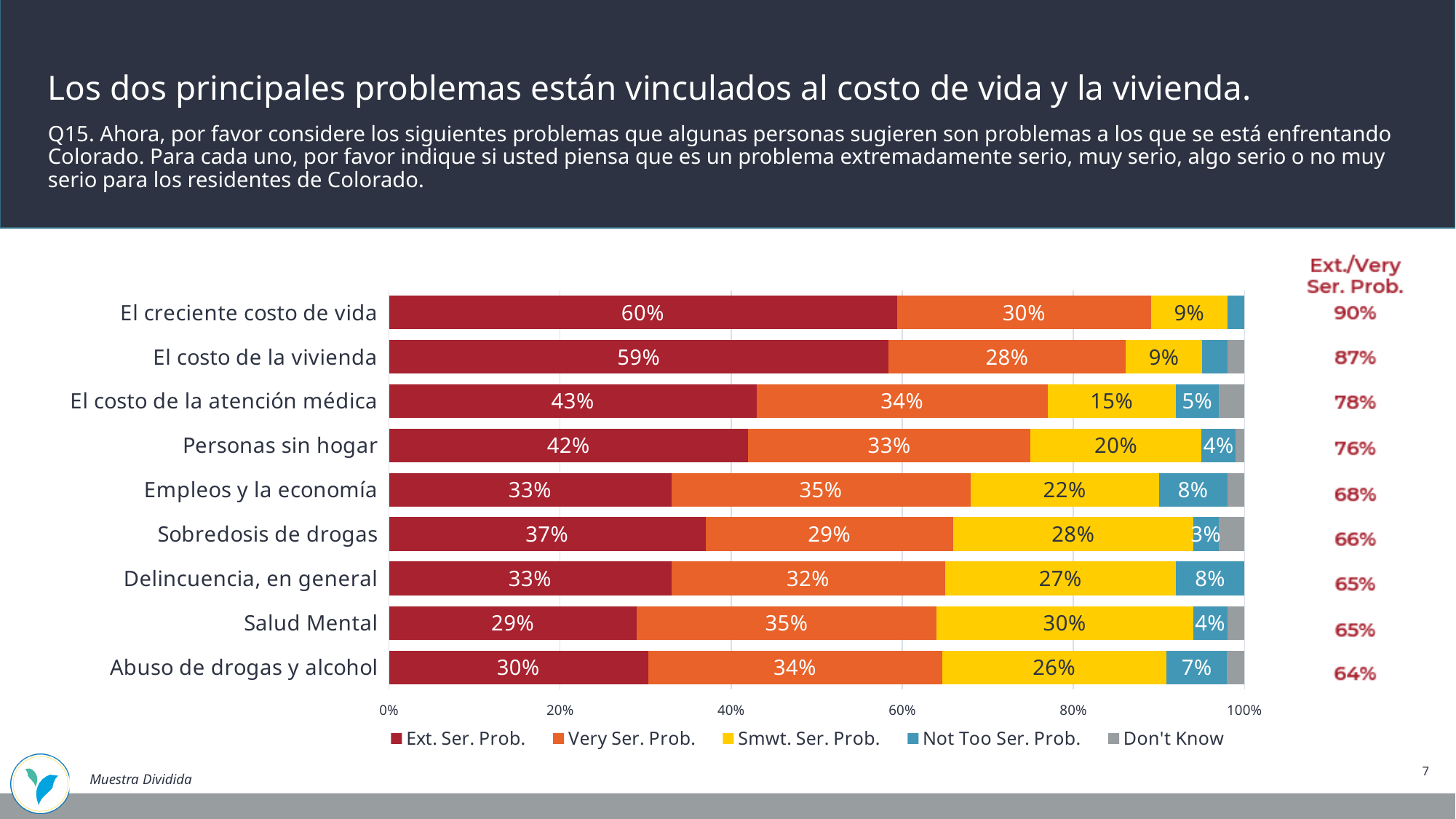
What kind of chart is shown on the slide? Stacked bar chart What is the difference between the 'Ext. Ser. Prob.' values for 'El creciente costo de vida' and 'Salud Mental'? 31 percentage points How many problem categories are shown in the chart? 9 What is the combined Ext./Very Ser. Prob. figure shown for 'El costo de la vivienda'? 87% What percentage of respondents rated 'El creciente costo de vida' as an extremely serious problem (Ext. Ser. Prob.)? 60% How many series does the legend list? 5 What is the 'Very Ser. Prob.' value for 'El costo de la atención médica'? 34% Which category has the highest 'Ext. Ser. Prob.' value? El creciente costo de vida Which has a larger 'Ext. Ser. Prob.' value: 'Sobredosis de drogas' or 'Delincuencia, en general'? Sobredosis de drogas Which category has the lowest 'Ext. Ser. Prob.' value? Salud Mental What is the 'Not Too Ser. Prob.' value for 'Empleos y la economía'? 8% What is the 'Smwt. Ser. Prob.' value for 'Personas sin hogar'? 20%